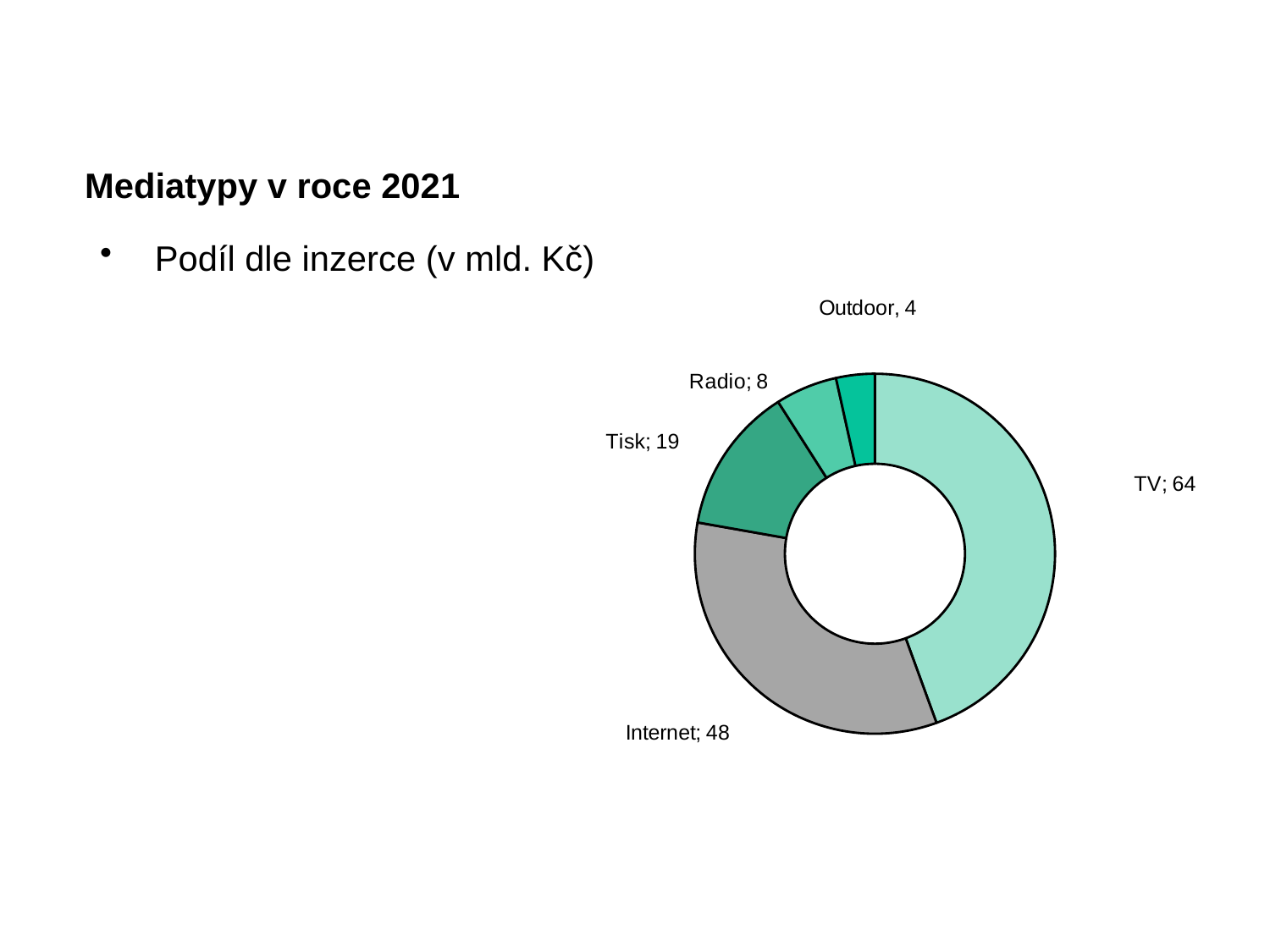
Which category has the largest slice in the chart? TV Which is larger, the value for Tisk or the value for Radio? Tisk What kind of chart is shown on the slide? Doughnut (pie) chart Which category has the smallest slice in the chart? Outdoor How many categories are shown in the chart? 5 What is the value for Internet in the chart? 48 What is the total of all the values shown in the chart? 143 What is the value for Tisk in the chart? 19 What is the value for Radio in the chart? 8 What is the title of the slide containing the chart? Mediatypy v roce 2021 What is the difference between the values for TV and Internet? 16 What is the value for TV in the chart? 64